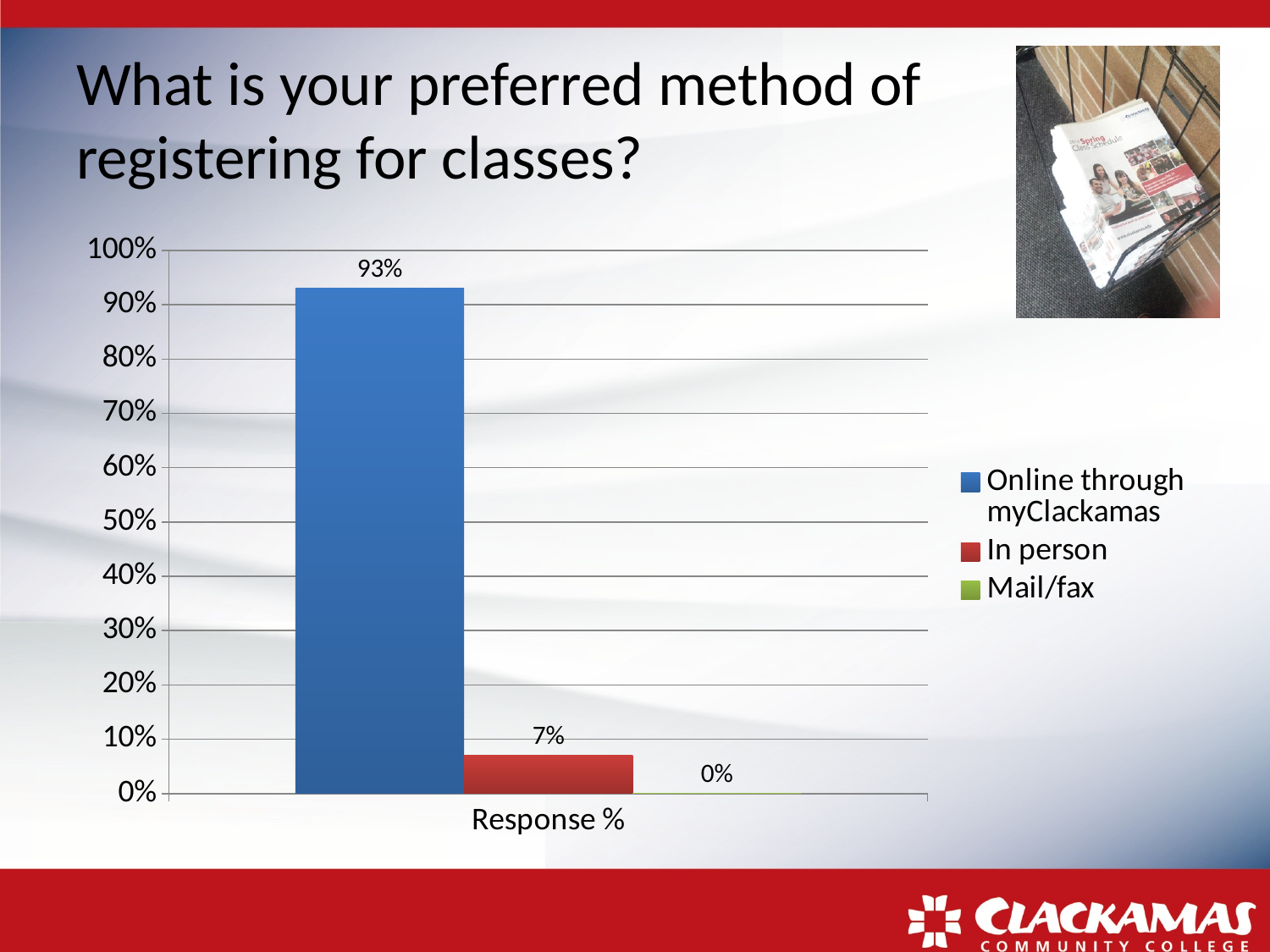
What is the value for Online through myClackamas? 93% What colour is the bar for In person? red What is the label on the x axis of the chart? Response % Which registration method has the lowest response percentage? Mail/fax Is the value for Online through myClackamas greater or less than 90%? greater What is the value for In person? 7% What kind of chart is shown on the slide? bar chart Which registration method has the highest response percentage? Online through myClackamas How many series does the legend list? 3 Which is larger, the value for In person or the value for Mail/fax? In person What is the value for Mail/fax? 0% What is the difference between the Online through myClackamas and In person values? 86%